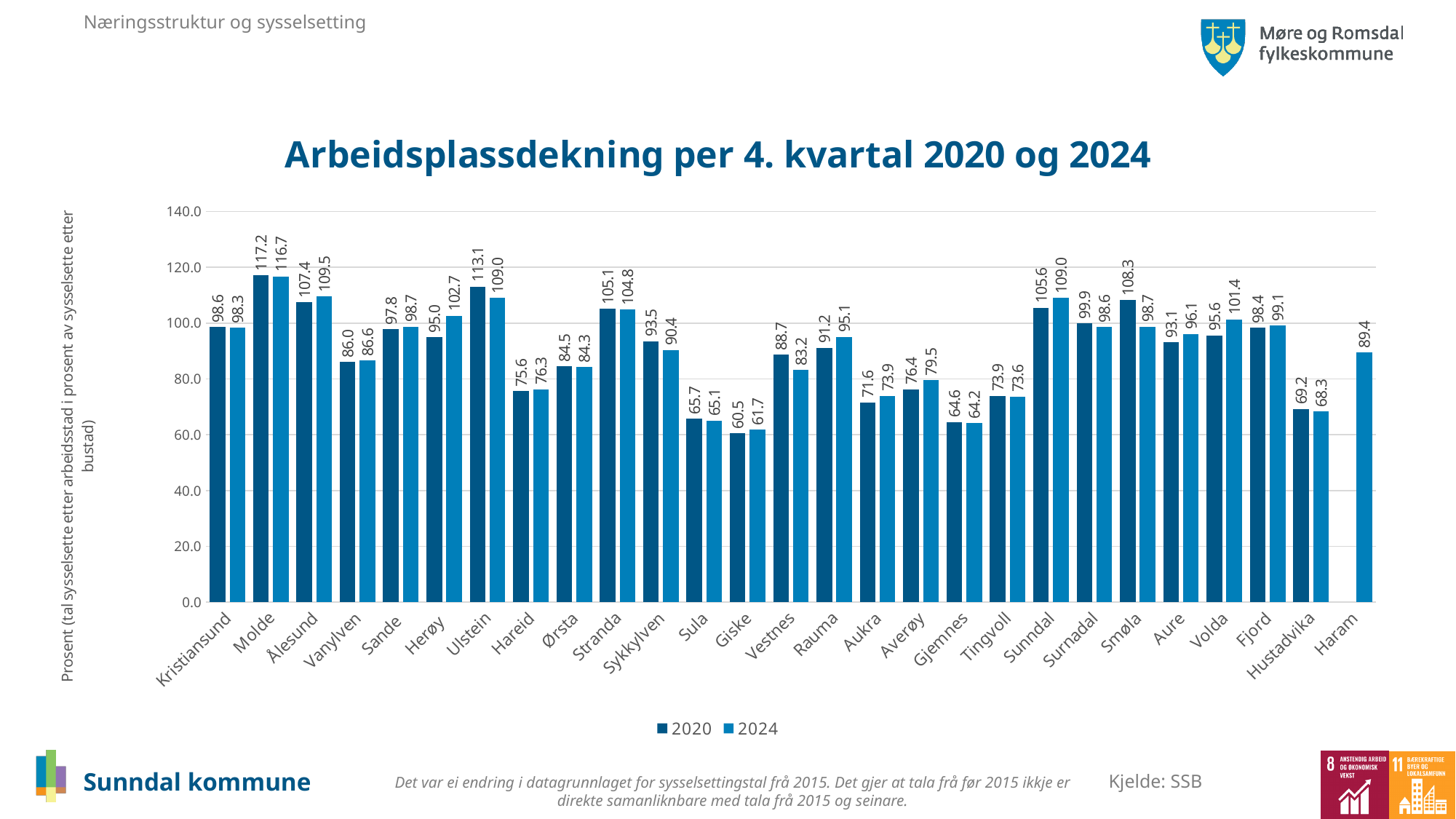
What kind of chart is shown on the slide? Bar chart Which municipality has the highest 2020 value? Molde What is the difference between the 2024 and 2020 values for Herøy? 7.7 What is the 2024 value for Haram? 89.4 What is the 2024 value for Herøy? 102.7 Which municipality has the lowest 2024 value? Giske How many municipalities are shown on the x axis? 27 What is the 2020 value for Sunndal? 105.6 Is the 2024 value for Volda greater or less than 100.0? greater Which is larger for Ulstein, the 2020 value or the 2024 value? 2020 How many series does the legend list? 2 What is the difference between the 2020 and 2024 values for Smøla? 9.6